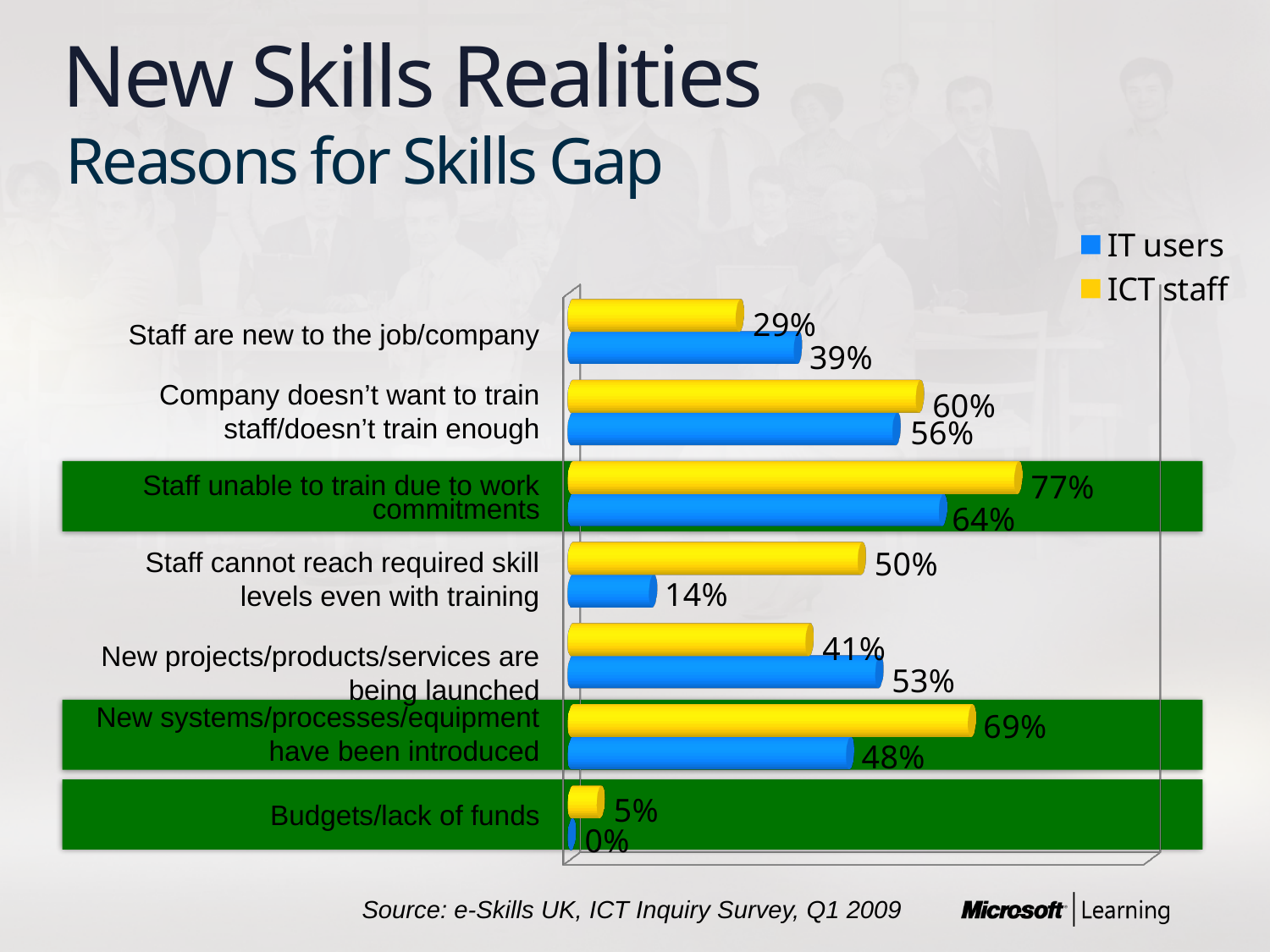
Which reason has the lowest IT users value? Budgets/lack of funds What is the IT users value for 'Budgets/lack of funds'? 0% What is the ICT staff value for 'Staff unable to train due to work commitments'? 77% Which colour represents the ICT staff series in the chart? Yellow For 'New projects/products/services are being launched', which series has the larger value, IT users or ICT staff? IT users How many reasons (categories) are shown in the chart? 7 How many series does the legend list? 2 Which reason has the highest ICT staff value? Staff unable to train due to work commitments What kind of chart is shown on the slide? Bar chart What is the IT users value for 'Staff cannot reach required skill levels even with training'? 14% What is the difference between the ICT staff and IT users values for 'Staff cannot reach required skill levels even with training'? 36% What is the difference between the ICT staff and IT users values for 'New systems/processes/equipment have been introduced'? 21%